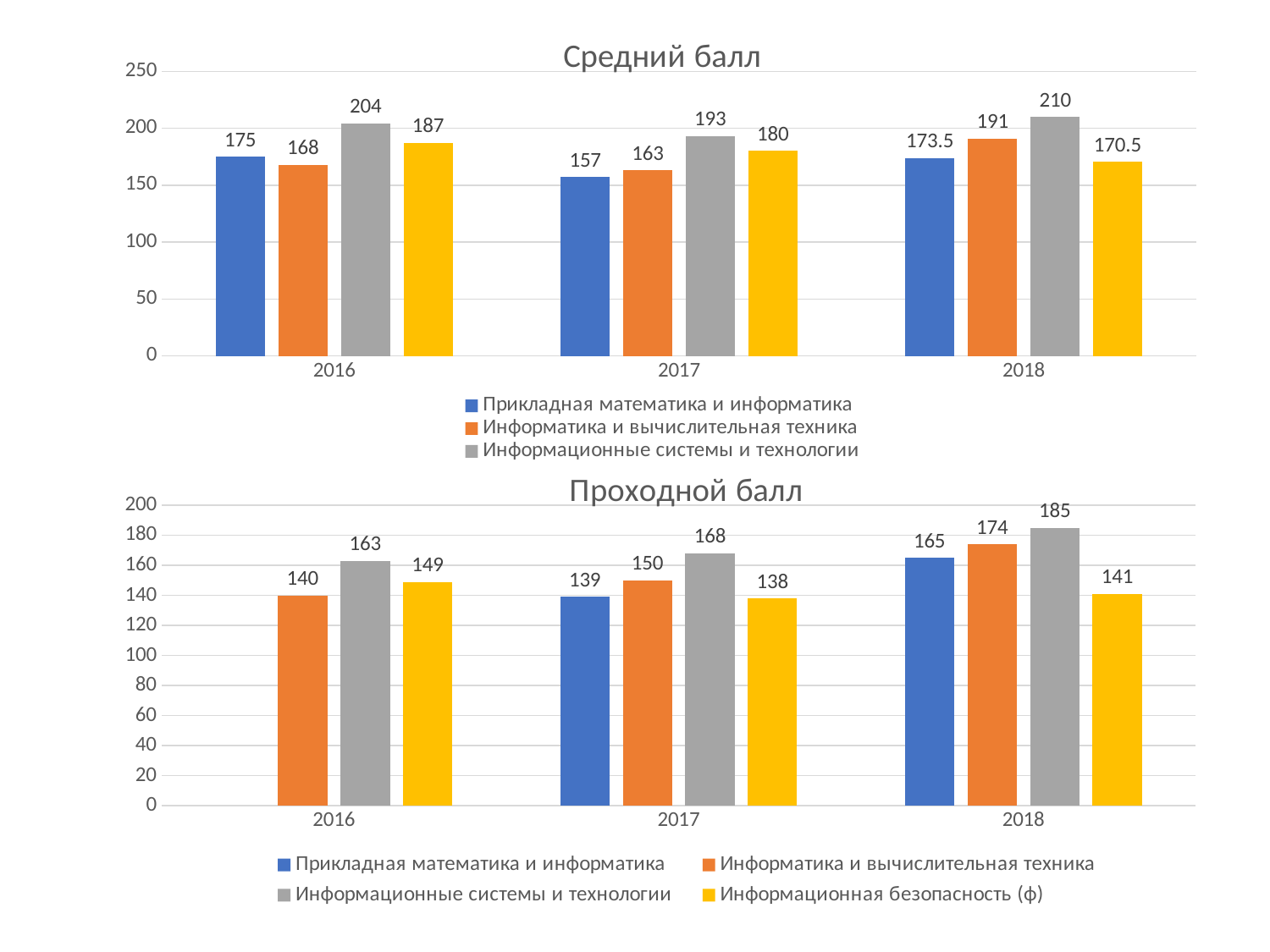
In the "Проходной балл" chart, which series has the lowest value in 2017? Информационная безопасность (ф) In the "Средний балл" chart, how many year categories are shown on the x axis? 3 In the "Средний балл" chart, what is the value for Информационные системы и технологии in 2018? 210 What kind of chart is the "Проходной балл" chart? Bar chart In the "Средний балл" chart, what is the value for Прикладная математика и информатика in 2017? 157 In the "Проходной балл" chart, what is the value for Информатика и вычислительная техника in 2018? 174 In the "Проходной балл" chart, does the value for Информационные системы и технологии rise or fall from 2016 to 2018? Rise In the "Средний балл" chart, which series has the highest value in 2016? Информационные системы и технологии In the "Проходной балл" chart, how many series does the legend list? 4 In the "Проходной балл" chart, is the value for Информационные системы и технологии in 2018 larger than the value for Прикладная математика и информатика in 2018? Yes In the "Проходной балл" chart, what is the difference between the 2018 and 2016 values for Информационная безопасность (ф)? 8 In the "Средний балл" chart, what is the difference between Информационные системы и технологии and Информатика и вычислительная техника in 2017? 30